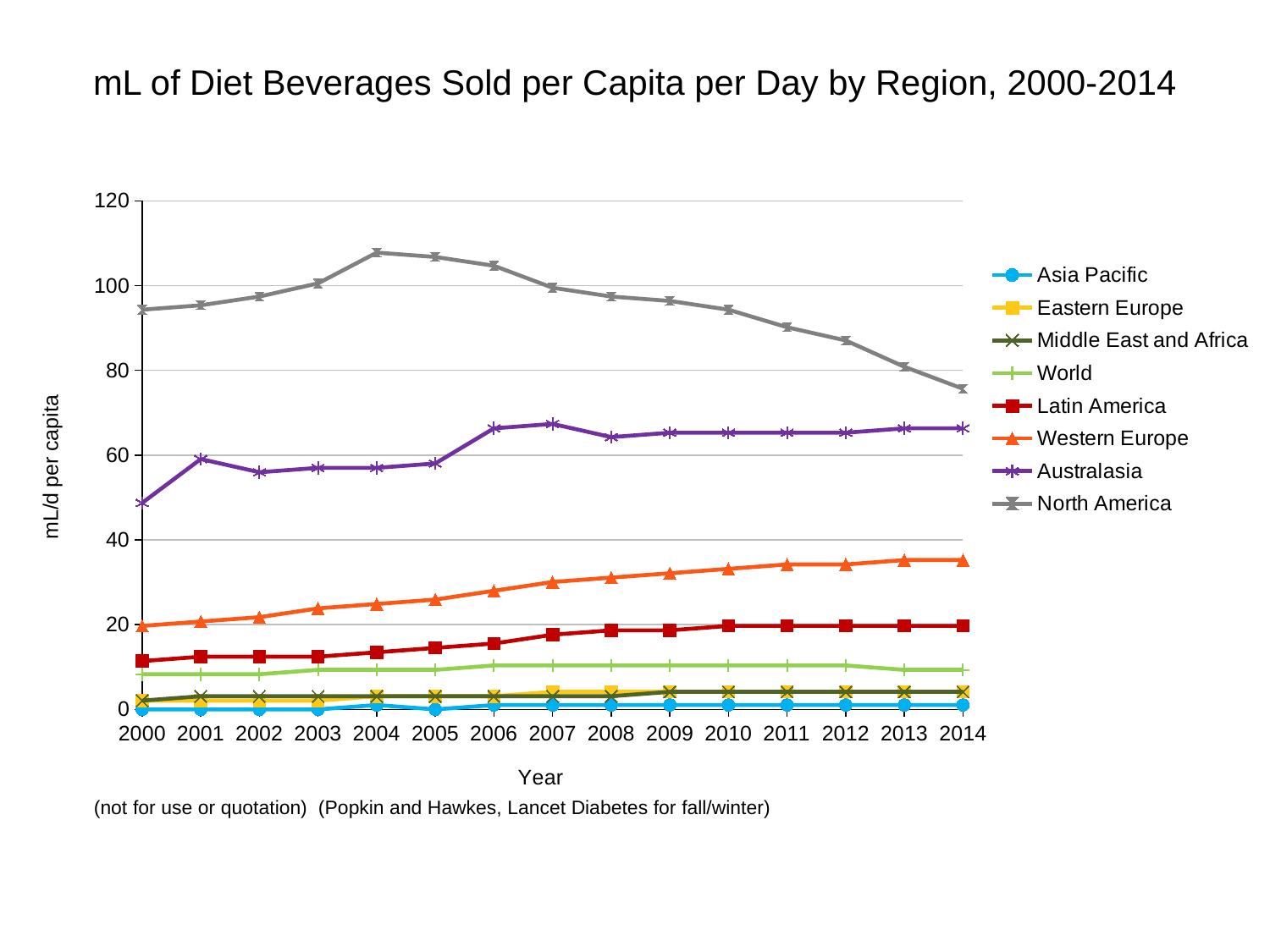
What kind of chart is shown on the slide? line chart How many years are plotted along the x axis? 15 How many regions (series) does the legend list? 8 Which region has the lowest mL of diet beverages sold per capita per day in 2014? Asia Pacific Does the value for North America rise or fall from 2004 to 2014? fall Which region has the highest mL of diet beverages sold per capita per day in 2014? North America Is the value for Australasia in 2000 greater or less than 60? less Is the value for North America in 2004 greater or less than 100? greater Is the value for North America in 2014 greater or less than 80? less In 2010, which is larger: the value for Australasia or the value for Western Europe? Australasia What is the label on the y axis of the chart? mL/d per capita